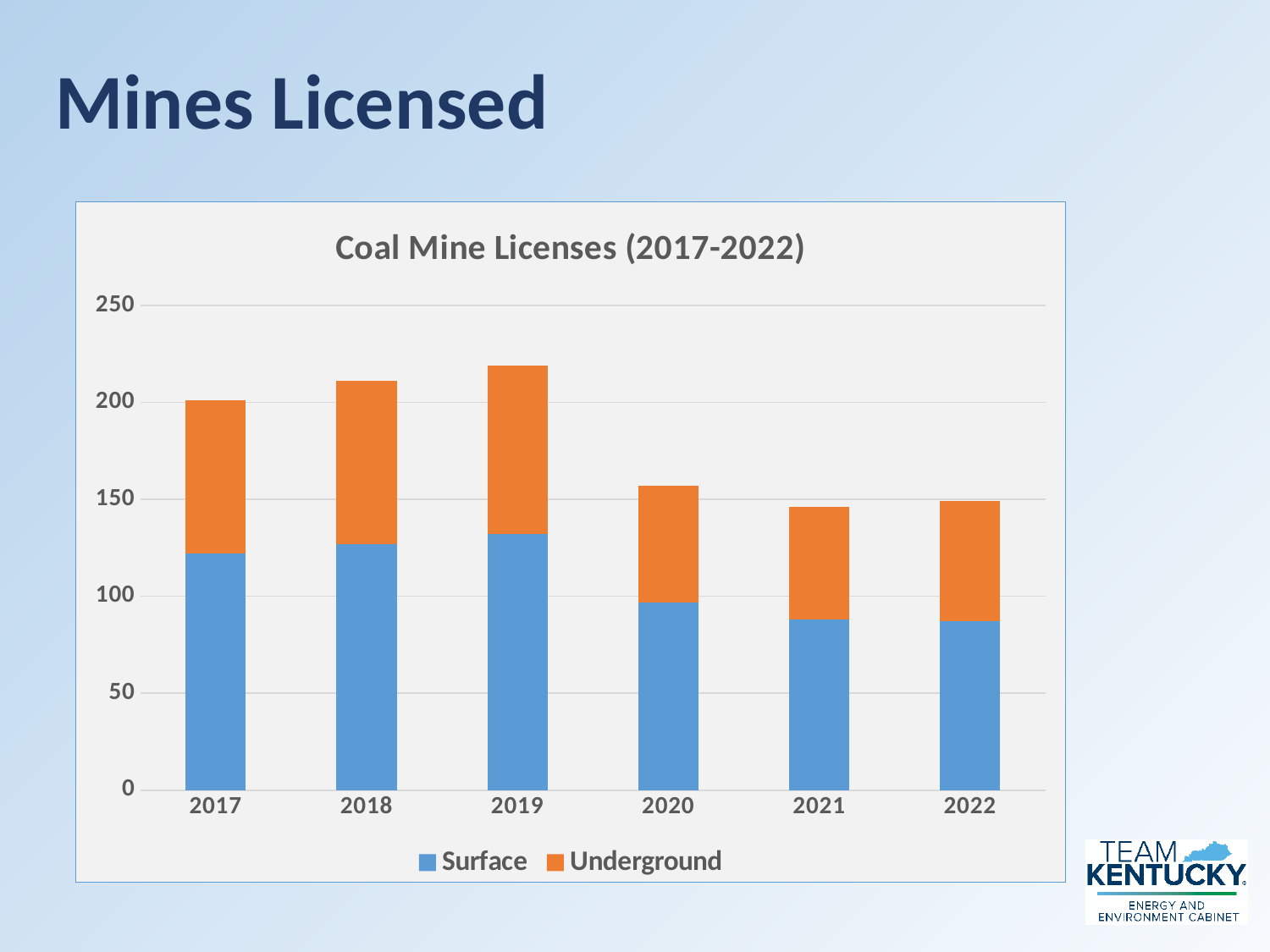
Which year has the highest total number of coal mine licenses? 2019 Is the total number of licenses for 2019 greater or less than 200? greater Which year has the larger total number of licenses, 2019 or 2020? 2019 Is the total number of licenses for 2018 greater or less than 200? greater Do the total licenses rise or fall from 2019 to 2021? fall Which year has the larger Surface value, 2018 or 2021? 2018 How many series does the legend list? 2 Is the Surface value for 2022 greater or less than 100? less What kind of chart is shown on the slide? Bar chart How many years are shown on the x axis? 6 What is the title of the chart? Coal Mine Licenses (2017-2022)